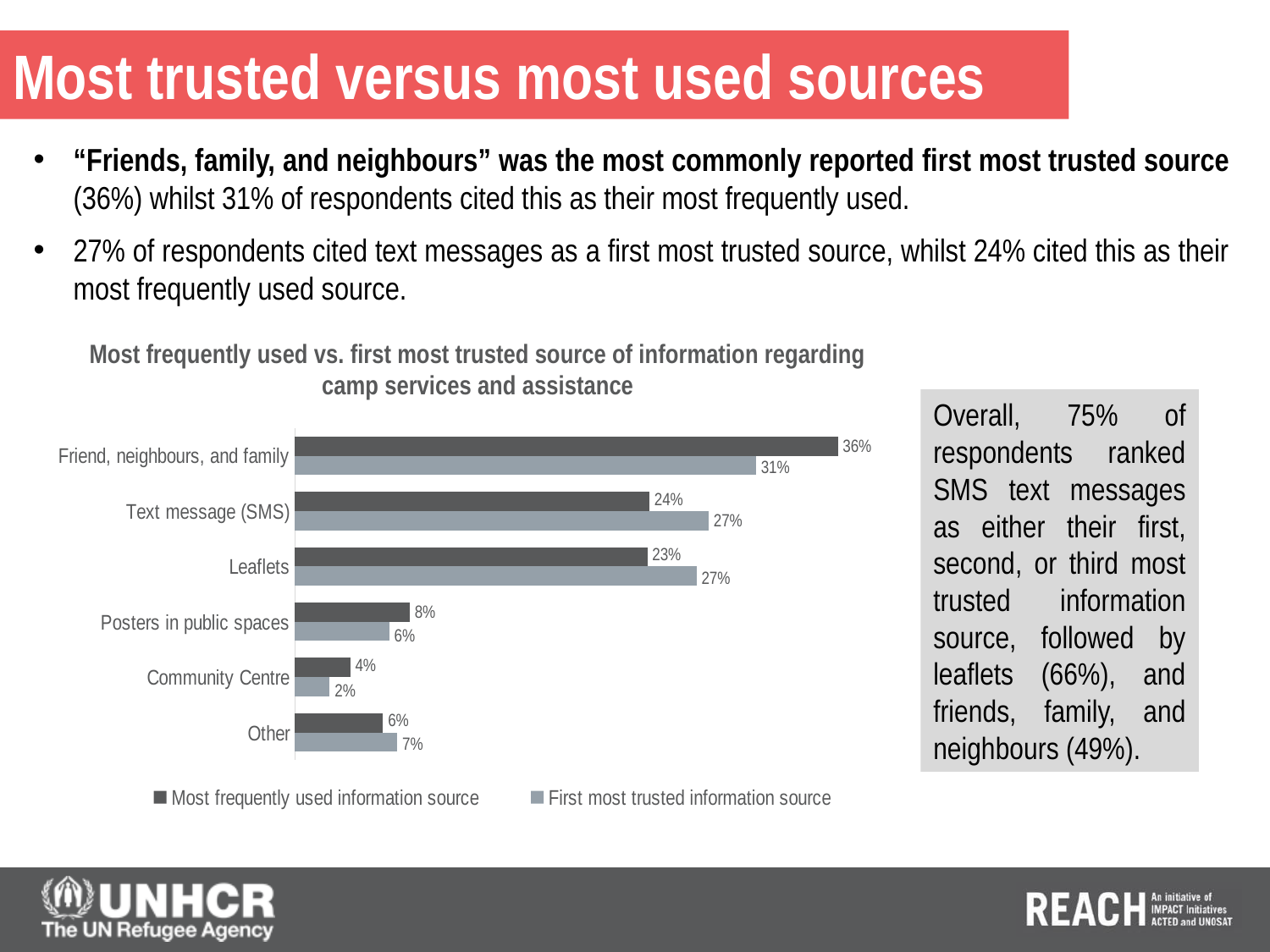
Which category has the lowest value for "First most trusted information source"? Community Centre What is the value for "First most trusted information source" for Leaflets? 27% Which category has the highest value for "Most frequently used information source"? Friend, neighbours, and family What is the value for "Most frequently used information source" for Friend, neighbours, and family? 36% What kind of chart is shown on the slide? Bar chart How many categories are shown on the chart? 6 For Posters in public spaces, which series has the larger value: "Most frequently used information source" or "First most trusted information source"? Most frequently used information source How many series does the legend list? 2 What is the difference between the "First most trusted" and "Most frequently used" values for Text message (SMS)? 3% What is the value for "First most trusted information source" for Community Centre? 2% What is the value for "Most frequently used information source" for Other? 6% What is the title of the chart? Most frequently used vs. first most trusted source of information regarding camp services and assistance